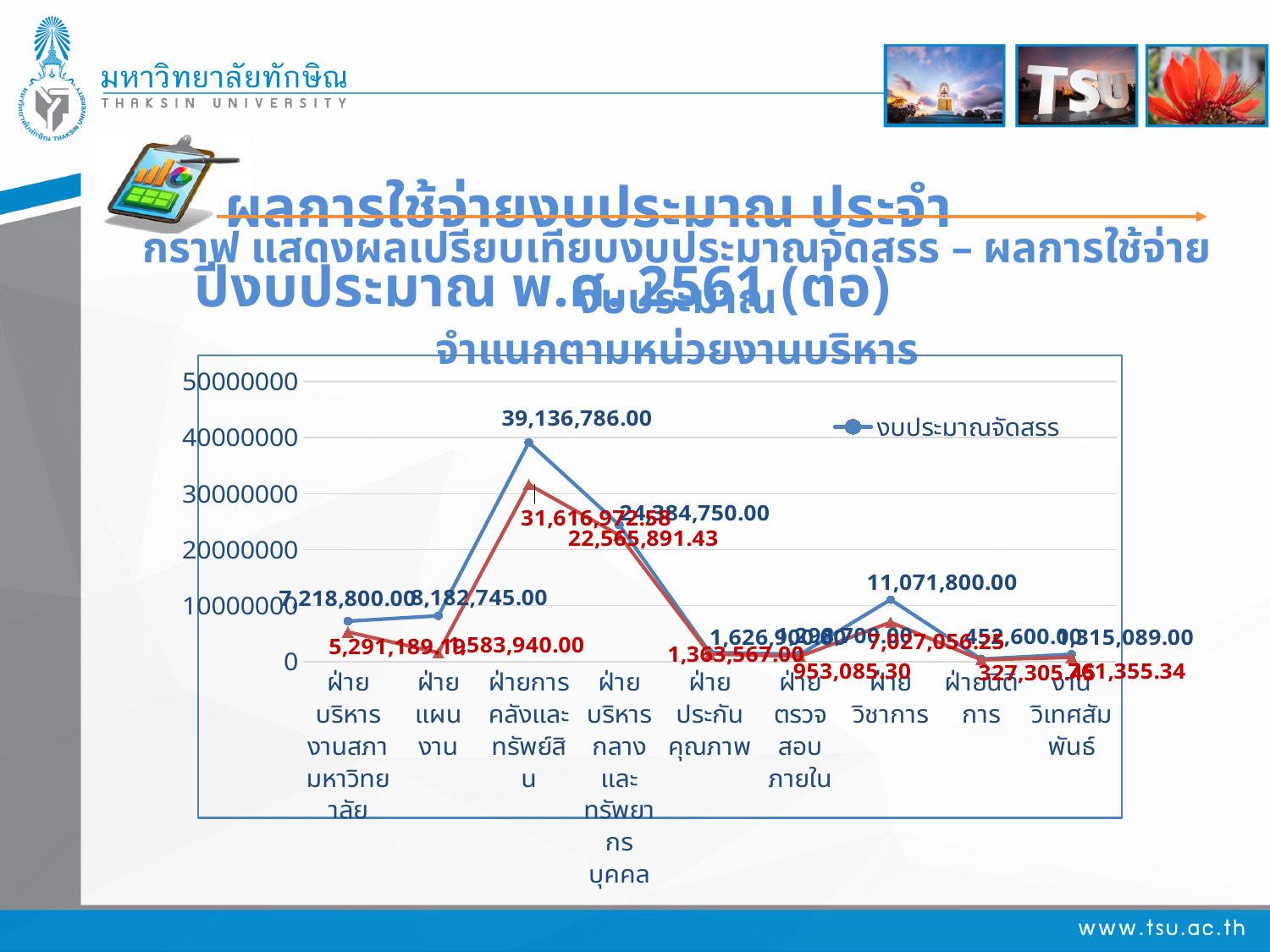
What is the expenditure value (red line) for ฝ่ายวิชาการ? 7,027,056.25 What is the expenditure value (red line) for ฝ่ายการคลังและทรัพย์สิน? 31,616,972.58 How many administrative units (categories) are shown on the x axis of the chart? 9 What is the difference between the allocated budget and the expenditure for ฝ่ายการคลังและทรัพย์สิน? 7,519,813.42 Is the allocated budget (blue line) for ฝ่ายการคลังและทรัพย์สิน greater or less than 30000000? greater What is the allocated budget (blue line) for ฝ่ายวิชาการ? 11,071,800.00 What type of chart is shown on the slide? line chart Which has the larger allocated budget (blue line): ฝ่ายบริหารงานสภามหาวิทยาลัย or ฝ่ายแผนงาน? ฝ่ายแผนงาน What series name is shown in the chart legend? งบประมาณจัดสรร What is the expenditure value (red line) for ฝ่ายแผนงาน? 1,583,940.00 Which unit has the highest allocated budget (งบประมาณจัดสรร, blue line)? ฝ่ายการคลังและทรัพย์สิน What is the allocated budget (blue line) for ฝ่ายการคลังและทรัพย์สิน? 39,136,786.00